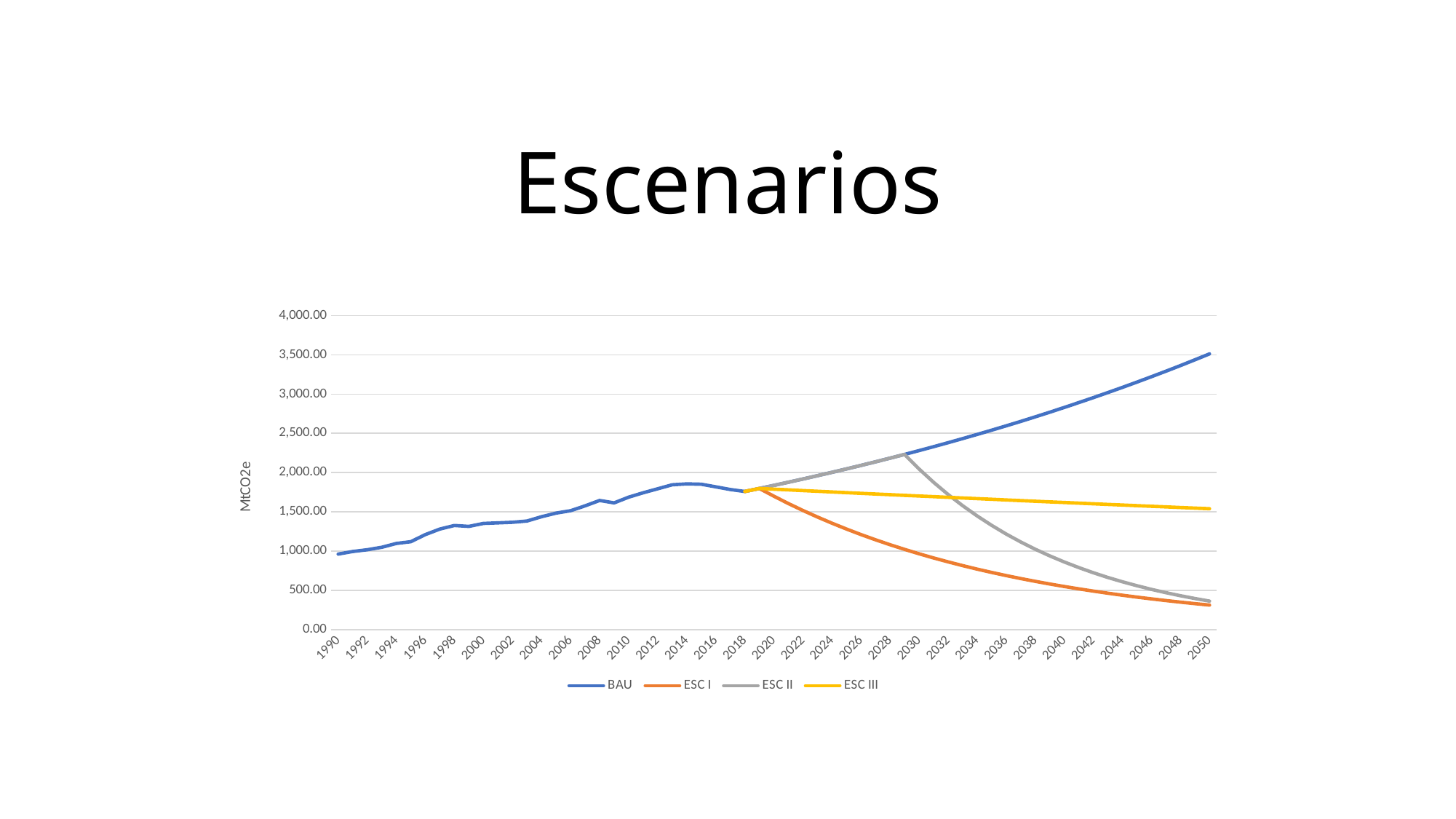
How many series does the legend list? 4 Is the value for BAU in 2050 greater or less than 3,000? greater What are the series names listed in the legend? BAU, ESC I, ESC II, ESC III Which series has the highest value in 2050? BAU Does the ESC I series rise or fall between 2020 and 2050? fall What is the label on the vertical axis? MtCO2e Is the value for ESC I in 2050 greater or less than 500? less Does the BAU series rise or fall between 2018 and 2050? rise In 2050, which is larger: BAU or ESC III? BAU What kind of chart is shown on the slide? line chart Is the value for ESC III in 2050 greater or less than 2,000? less